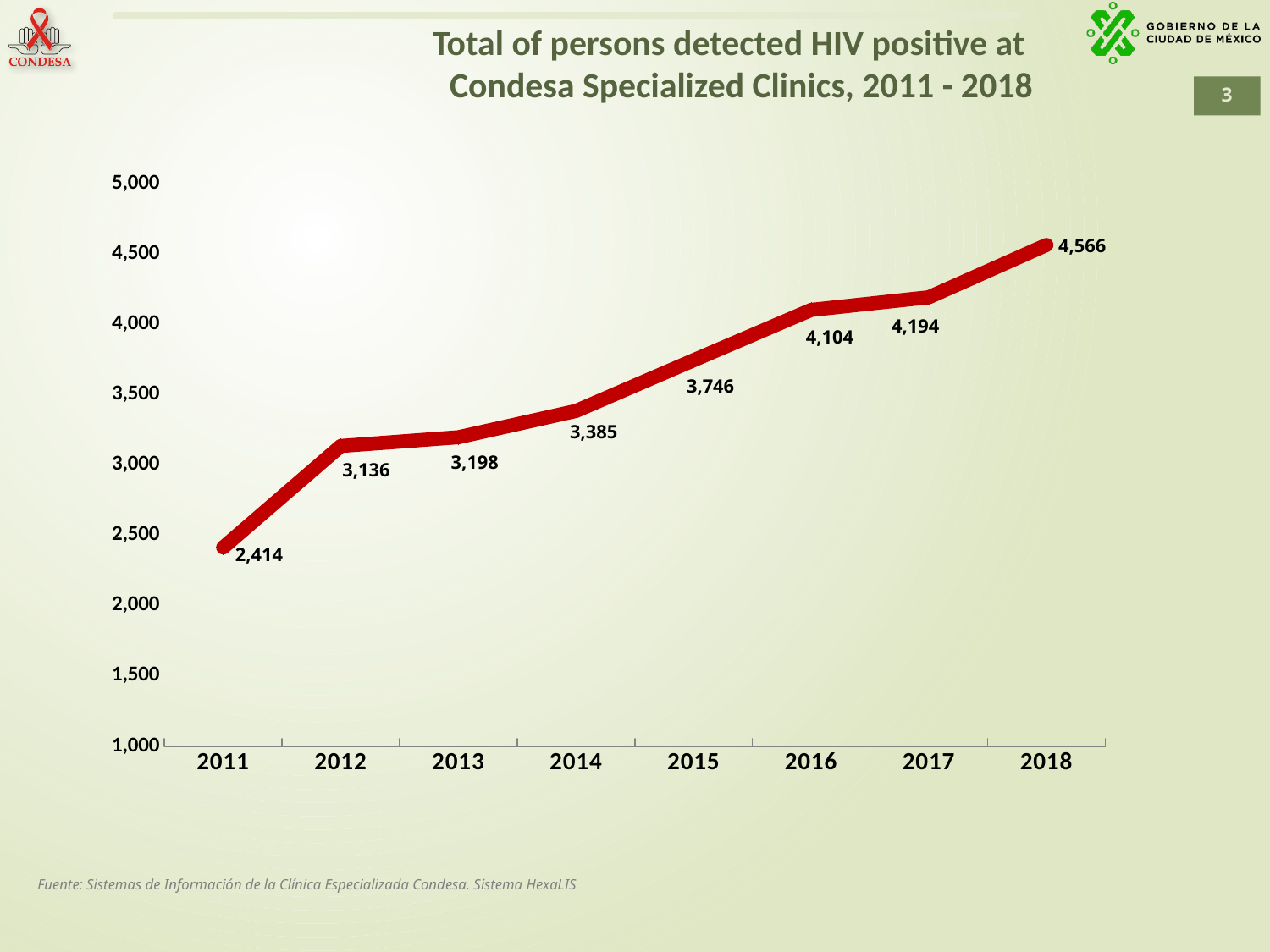
How many years are plotted on the x axis? 8 What is the value for 2011? 2,414 What is the difference between the values for 2013 and 2012? 62 What is the difference between the values for 2018 and 2011? 2,152 Do the values rise or fall from 2011 to 2018? rise Which year has the highest value? 2018 Which is larger, the value for 2016 or the value for 2014? 2016 What is the value for 2015? 3,746 What is the value for 2018? 4,566 Is the value for 2017 greater or less than 4,000? greater Which year has the lowest value? 2011 What kind of chart is shown on the slide? line chart